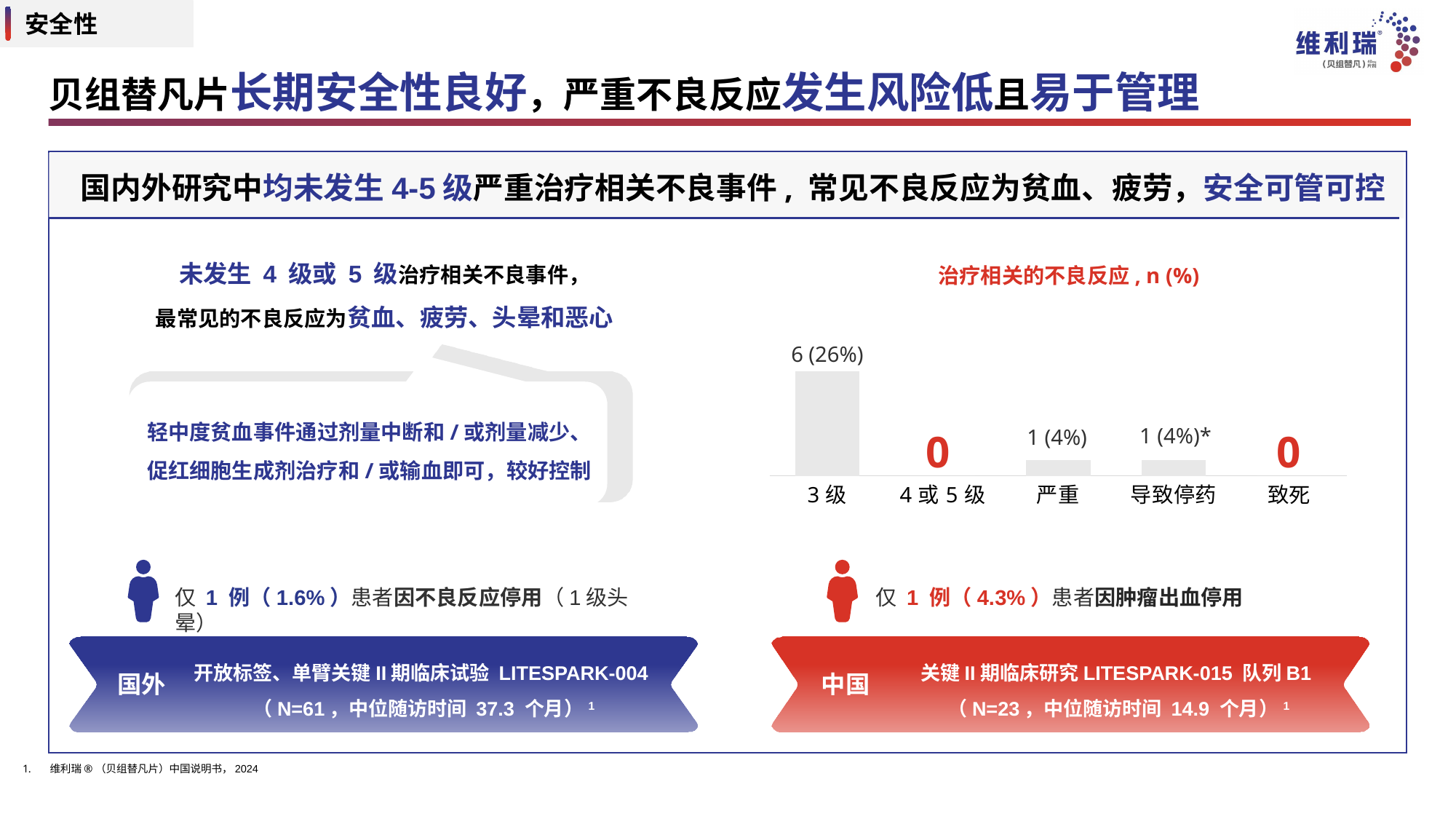
What is the value labelled for the 严重 category in the chart? 1 (4%) What is the value labelled for the 3级 category in the chart? 6 (26%) What is the title of the chart on the slide? 治疗相关的不良反应, n (%) How many categories are shown on the x axis of the chart? 5 What is the value labelled for the 致死 category in the chart? 0 Which is larger in the chart, the value for 3级 or the value for 导致停药? 3级 What is the difference in count between the 3级 category and the 严重 category in the chart? 5 Which category has the highest value in the chart? 3级 What is the value labelled for the 导致停药 category in the chart? 1 (4%)* What is the value labelled for the 4或5级 category in the chart? 0 How many categories in the chart have a value of 0? 2 What type of chart is shown under the title 治疗相关的不良反应, n (%)? bar chart